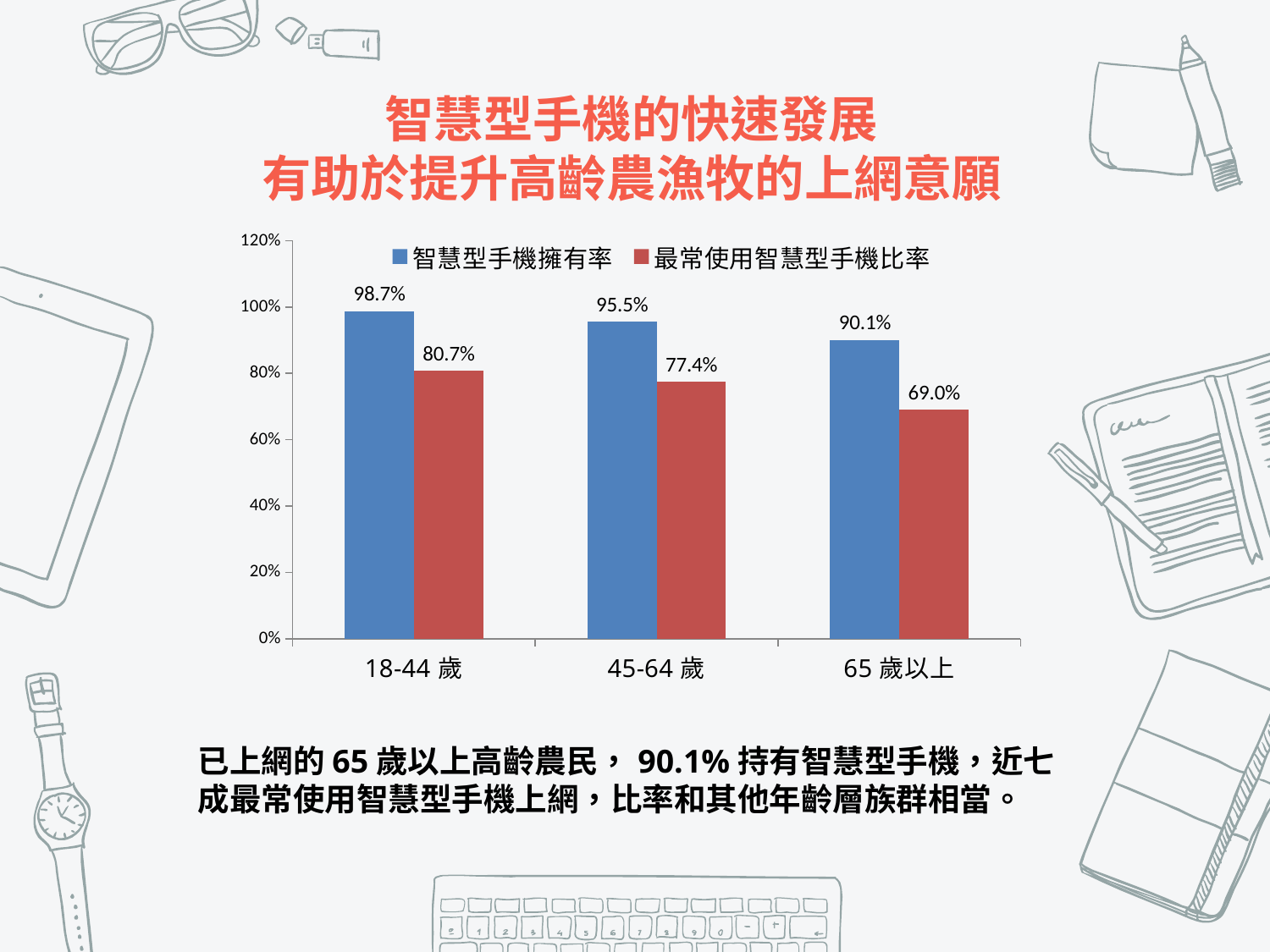
Which is larger: the 最常使用智慧型手機比率 for 18-44 歲 or for 45-64 歲? 18-44 歲 How many age groups are shown on the x axis? 3 What kind of chart is shown on the slide? Bar chart Is the 智慧型手機擁有率 for the 65 歲以上 group greater or less than 80%? greater How many series does the legend list? 2 What is the 智慧型手機擁有率 value for the 18-44 歲 group? 98.7% Which age group has the highest 智慧型手機擁有率? 18-44 歲 What is the 最常使用智慧型手機比率 value for the 45-64 歲 group? 77.4% What is the difference between 智慧型手機擁有率 and 最常使用智慧型手機比率 for the 65 歲以上 group? 21.1% Which age group has the lowest 最常使用智慧型手機比率? 65 歲以上 Do the 智慧型手機擁有率 values rise or fall from 18-44 歲 to 65 歲以上? Fall What is the 最常使用智慧型手機比率 value for the 65 歲以上 group? 69.0%